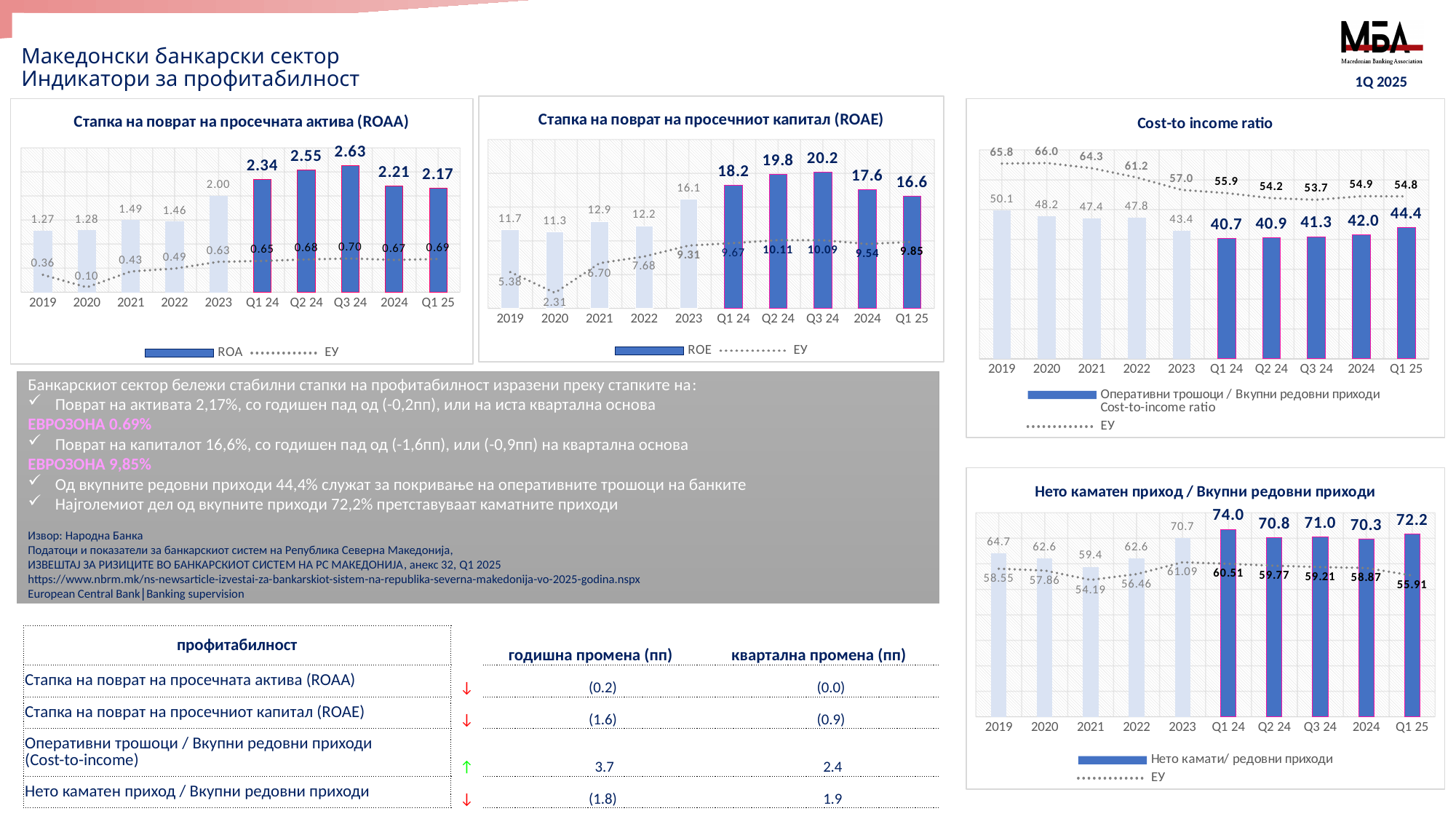
In the ROAE chart, which year has the lowest EU (ЕУ) value? 2020 In the Cost-to income ratio chart, what is the bar value for 2019? 50.1 In the ROAE chart, what is the difference between the ROE values for Q3 24 and Q1 25? 3.6 In the Нето каматен приход / Вкупни редовни приходи chart, what is the bar value for Q1 24? 74.0 In the ROAA chart, which period has the highest ROA bar? Q3 24 In the ROAA chart, what is the ROA value for Q3 24? 2.63 In the Нето каматен приход / Вкупни редовни приходи chart, how many periods are shown on the x axis? 10 In the ROAA chart, what is the EU (ЕУ) value for 2020? 0.10 In the Cost-to income ratio chart, is the EU (ЕУ) value for Q1 25 larger or smaller than the bar value for Q1 25? larger In the Cost-to income ratio chart, which period has the lowest bar value? Q1 24 How many series does the legend of the Cost-to income ratio chart list? 2 In the ROAE chart, what is the ROE value for Q1 25? 16.6